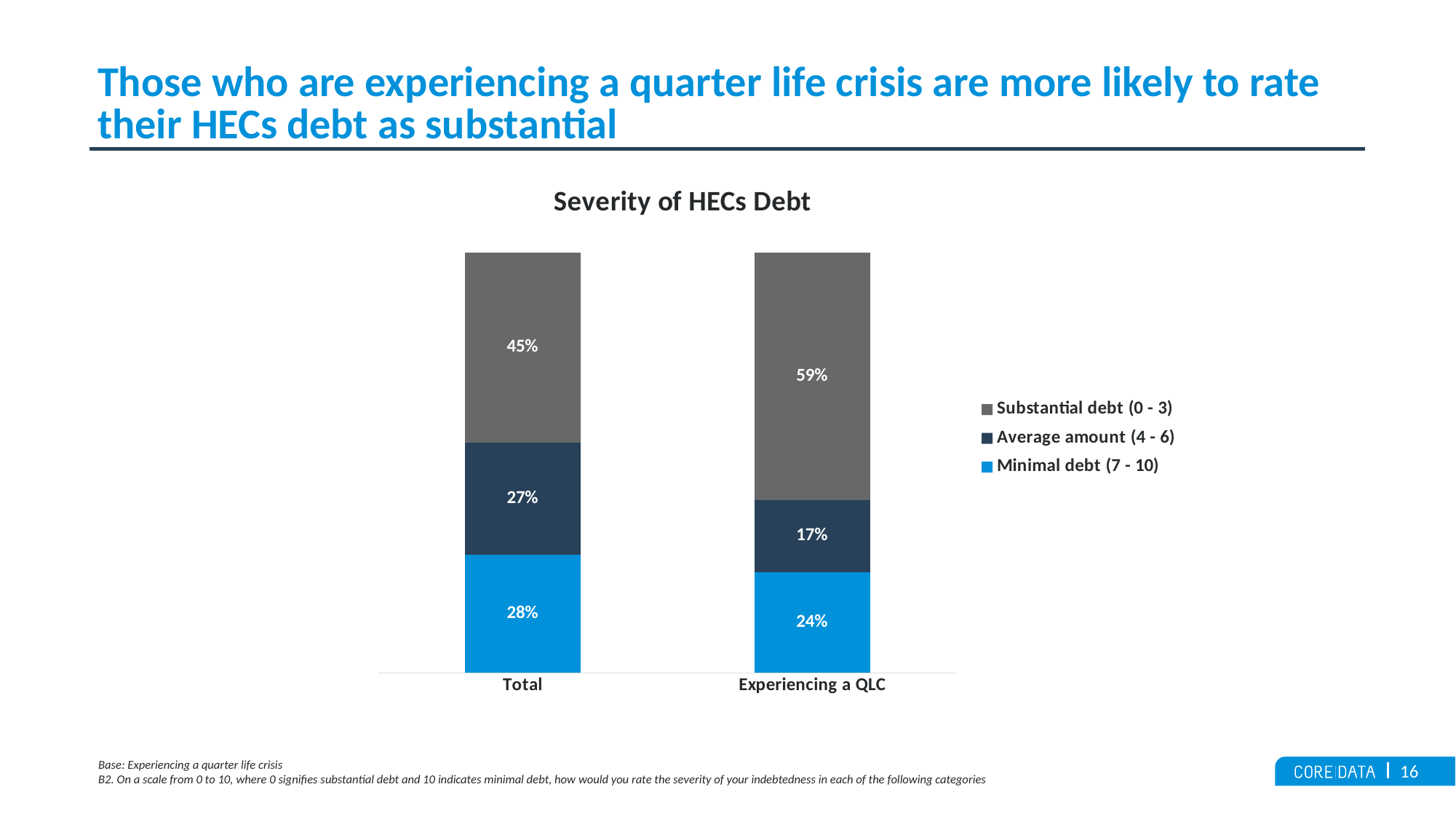
What is the difference between the Substantial debt (0 - 3) values for Experiencing a QLC and Total? 14% Which segment is the largest in the Experiencing a QLC bar? Substantial debt (0 - 3) What type of chart is shown? Stacked bar chart How many series does the legend list? 3 Which category has the larger Minimal debt (7 - 10) value, Total or Experiencing a QLC? Total What is the value for Substantial debt (0 - 3) in the Total bar? 45% What is the value for Average amount (4 - 6) in the Experiencing a QLC bar? 17% What is the value for Minimal debt (7 - 10) in the Total bar? 28% Which segment is the smallest in the Experiencing a QLC bar? Average amount (4 - 6) What is the difference between the Average amount (4 - 6) values for Total and Experiencing a QLC? 10% How many categories are shown on the x axis? 2 What is the value for Substantial debt (0 - 3) in the Experiencing a QLC bar? 59%